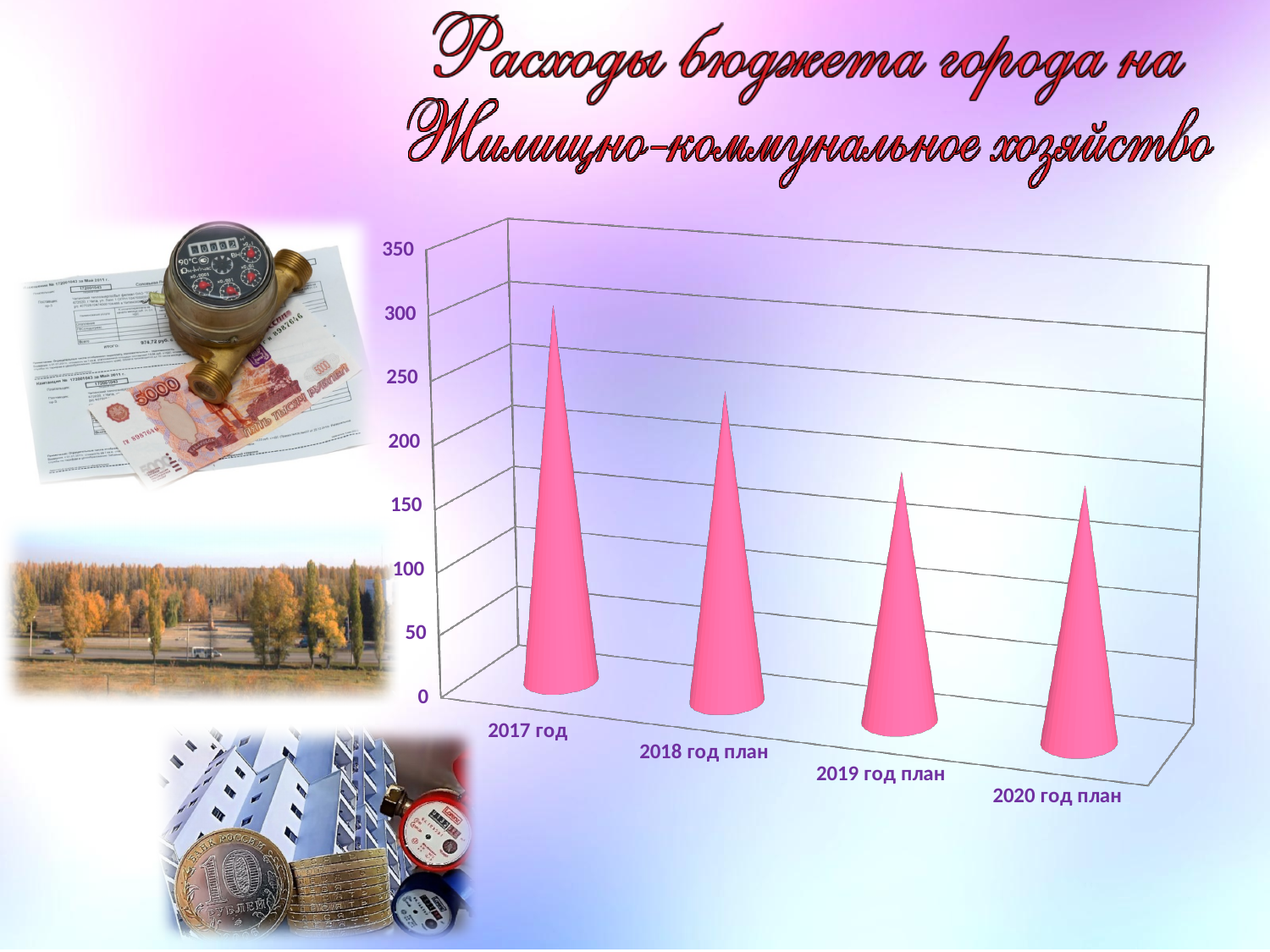
What kind of chart is shown on the slide? bar chart Is the value for 2018 год план greater or less than 300? less Is the value for 2020 год план greater or less than 300? less Is the value for 2017 год greater or less than 250? greater Which is larger, the value for 2018 год план or the value for 2019 год план? 2018 год план What is the title of the slide above the chart? Расходы бюджета города на Жилищно-коммунальное хозяйство Do the values rise or fall from 2017 год to 2020 год план? fall How many categories are plotted on the chart? 4 Which is larger, the value for 2017 год or the value for 2018 год план? 2017 год Which category has the highest value on the chart? 2017 год Which is larger, the value for 2017 год or the value for 2020 год план? 2017 год